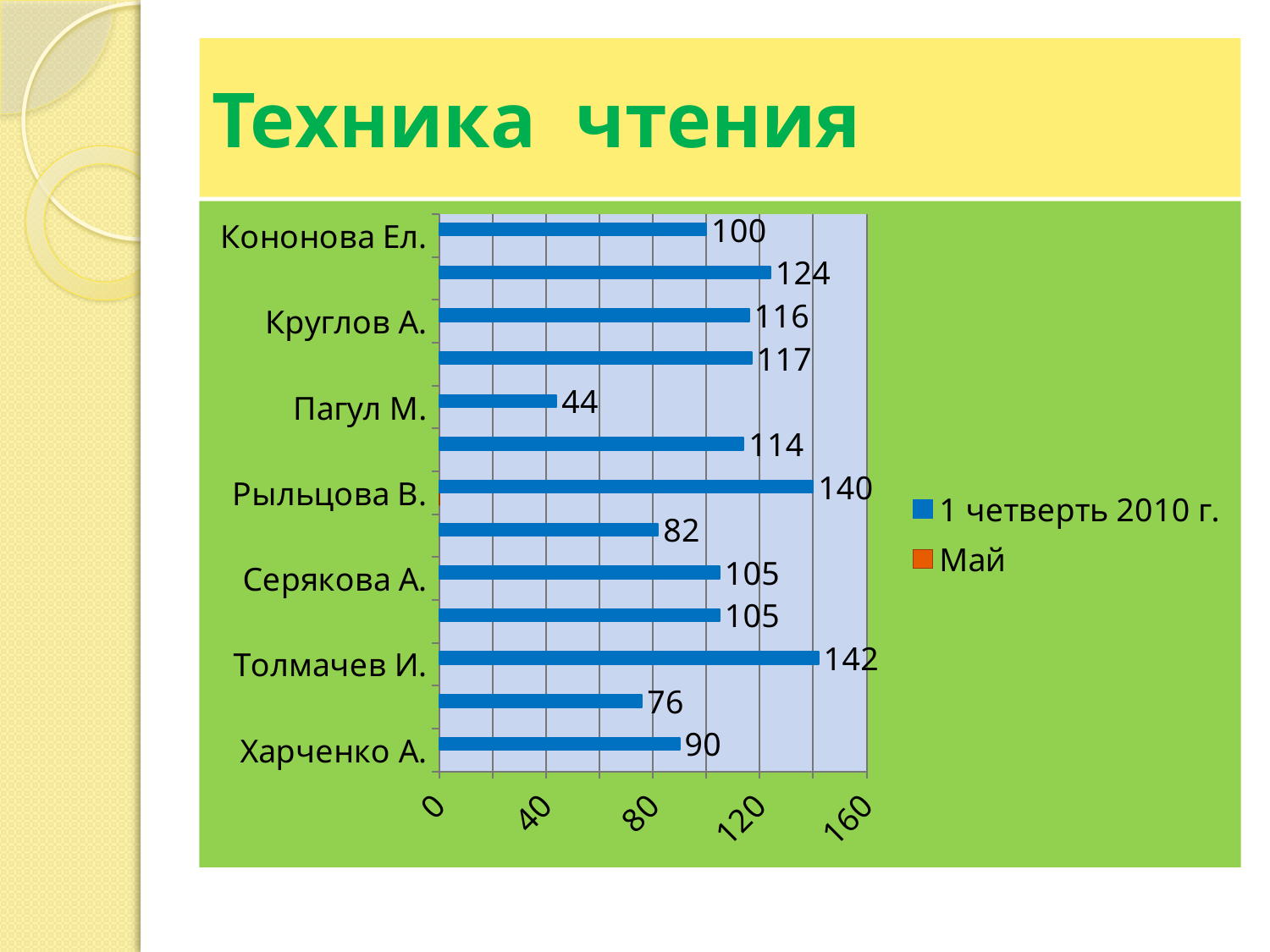
What is the difference between the values for Рыльцова В. and Серякова А.? 35 Is the value for Рыльцова В. greater or less than 120? greater Which labelled category has the lowest value? Пагул М. How many series does the legend list? 2 What kind of chart is shown on the slide? bar chart Which is larger, the value for Круглов А. or the value for Харченко А.? Круглов А. What is the value for Харченко А.? 90 What is the value for Пагул М.? 44 What is the value for Толмачев И.? 142 Which labelled category has the highest value? Толмачев И. How many bars are plotted in the chart? 13 What is the value for Кононова Ел.? 100